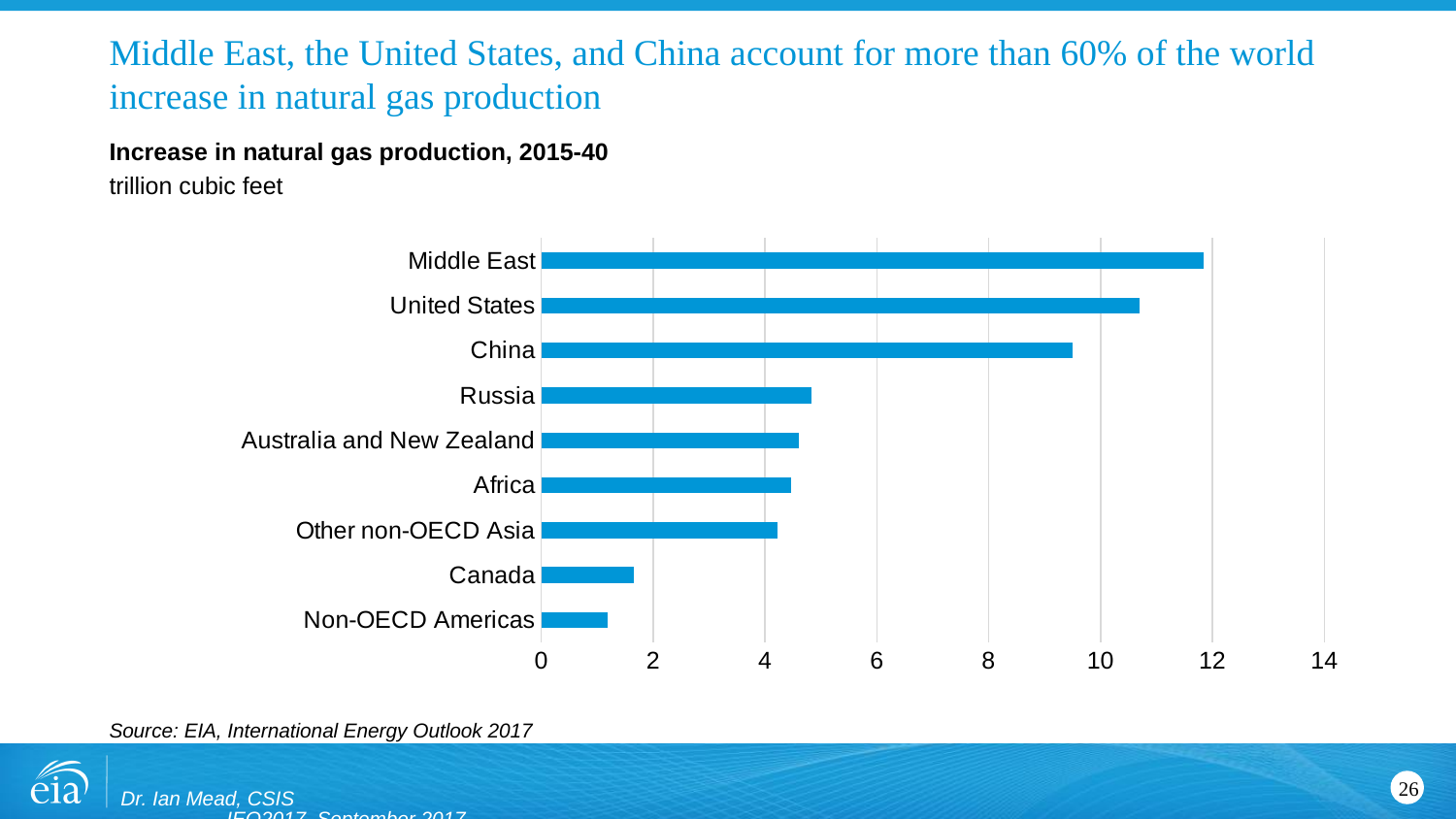
What unit is the chart measured in? trillion cubic feet Is the value for Africa greater or less than 6? less Which region has the smallest increase in natural gas production, 2015-40? Non-OECD Americas Is the value for Canada greater or less than 2? less How many regions are shown in the chart? 9 Is the value for China greater or less than 10? less Which region has the largest increase in natural gas production, 2015-40? Middle East What kind of chart is shown on the slide? bar chart Which has a larger increase in natural gas production, Middle East or United States? Middle East Which has a larger increase in natural gas production, China or Russia? China